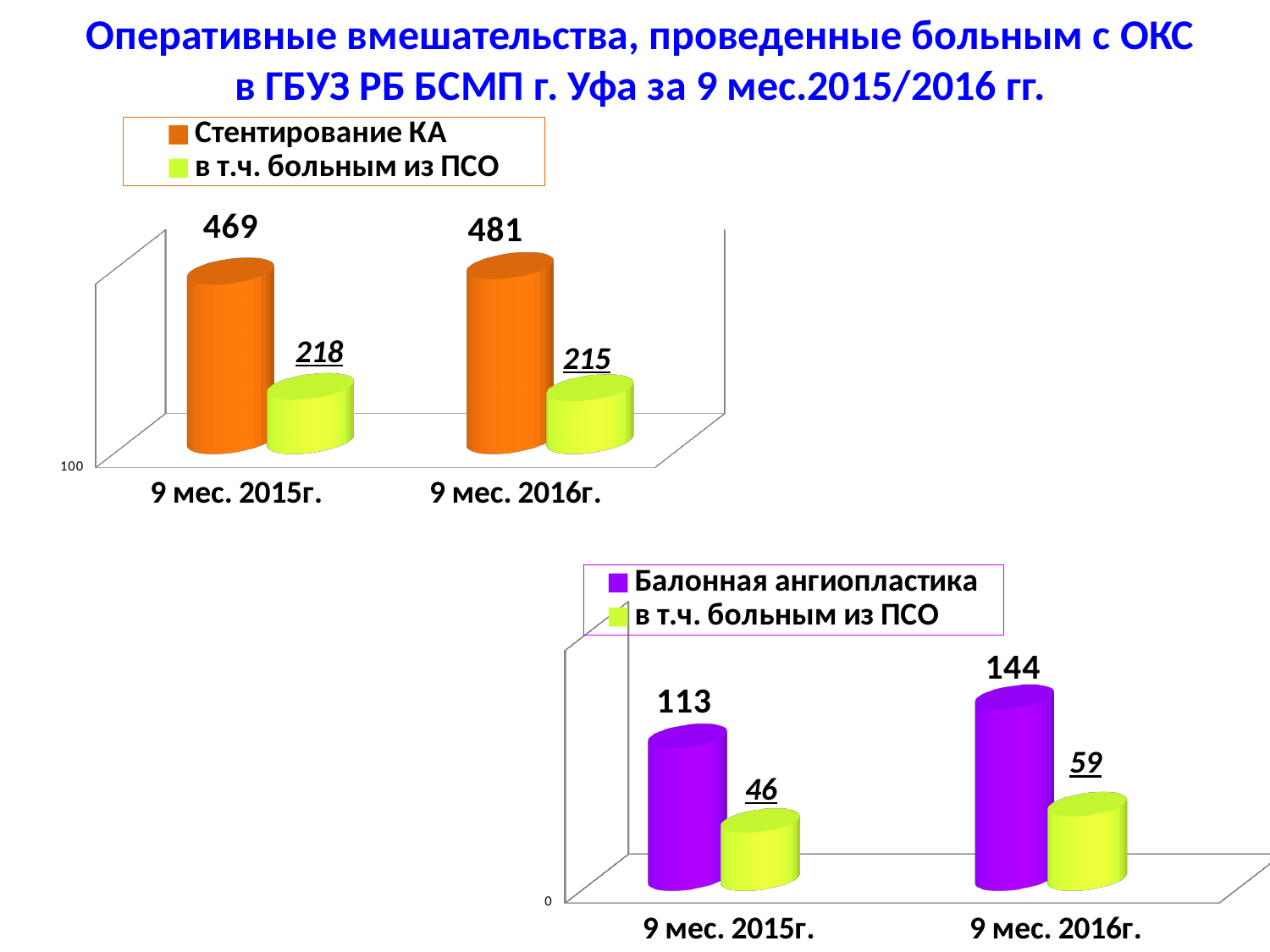
In the top-left chart (Стентирование КА), what is the value for Стентирование КА in 9 мес. 2016г.? 481 In the top-left chart (Стентирование КА), what is the difference between Стентирование КА and в т.ч. больным из ПСО in 9 мес. 2016г.? 266 In the bottom-right chart (Балонная ангиопластика), how many categories are shown on the x axis? 2 In the top-left chart (Стентирование КА), did the value for Стентирование КА rise or fall from 9 мес. 2015г. to 9 мес. 2016г.? rise In the top-left chart (Стентирование КА), how many series does the legend list? 2 In the bottom-right chart (Балонная ангиопластика), what is the value for Балонная ангиопластика in 9 мес. 2016г.? 144 In the bottom-right chart (Балонная ангиопластика), which period has the higher value for в т.ч. больным из ПСО, 9 мес. 2015г. or 9 мес. 2016г.? 9 мес. 2016г. In the top-left chart (Стентирование КА), what is the value for Стентирование КА in 9 мес. 2015г.? 469 In the bottom-right chart (Балонная ангиопластика), what is the value for в т.ч. больным из ПСО in 9 мес. 2015г.? 46 What kind of chart is the bottom-right chart (Балонная ангиопластика)? bar chart In the top-left chart (Стентирование КА), what is the value for в т.ч. больным из ПСО in 9 мес. 2015г.? 218 In the bottom-right chart (Балонная ангиопластика), what is the difference between the Балонная ангиопластика values for 9 мес. 2016г. and 9 мес. 2015г.? 31